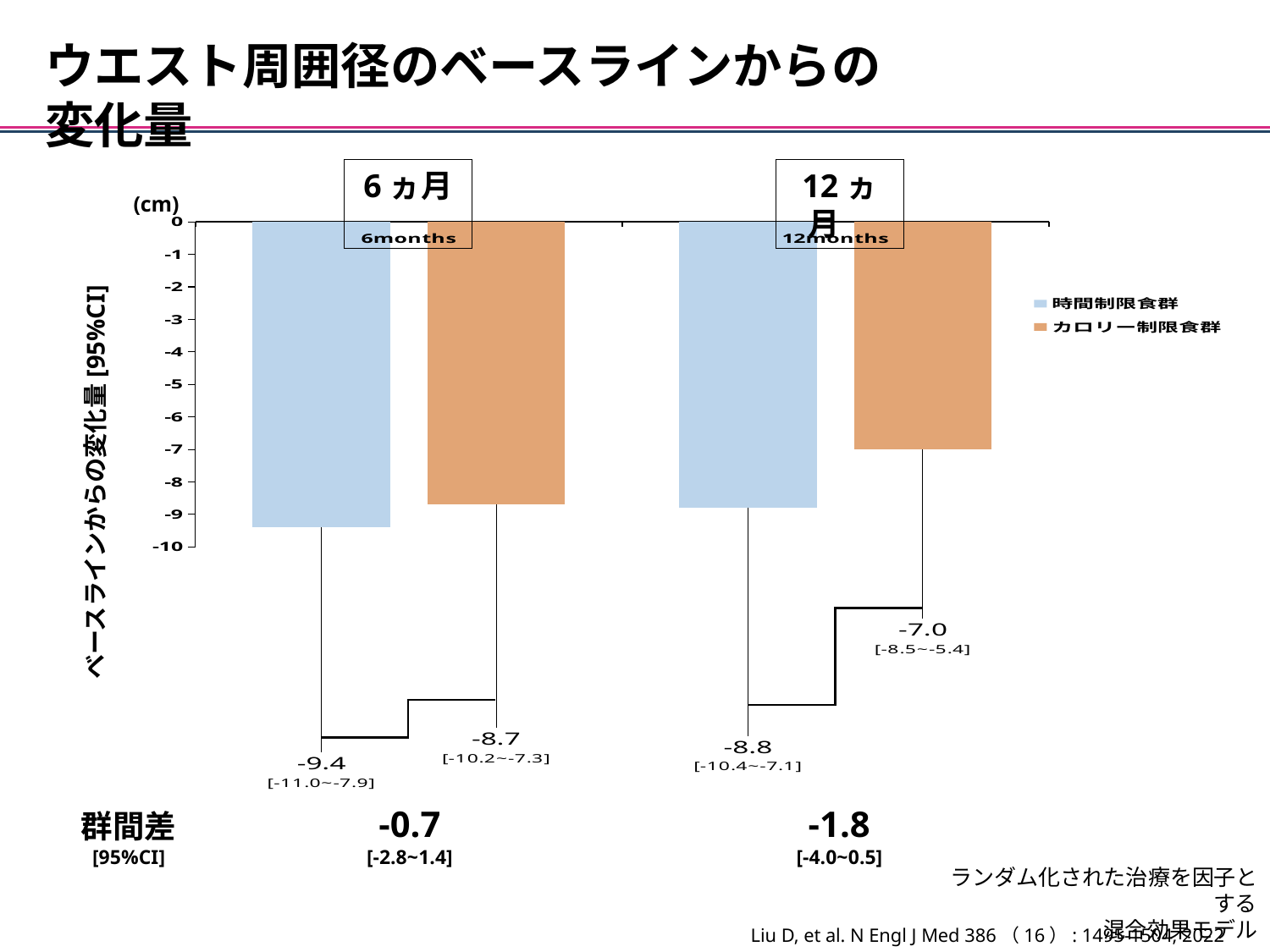
What is the value for the カロリー制限食群 at 6months? -8.7 Which bar shows the smallest decrease from baseline? カロリー制限食群 at 12months What is the value for the 時間制限食群 at 12months? -8.8 What is the value for the カロリー制限食群 at 12months? -7.0 How many series does the legend list? 2 What is the value for the 時間制限食群 at 6months? -9.4 What kind of chart is shown on the slide? bar chart What is the 群間差 (between-group difference) shown for 12months? -1.8 Which bar shows the largest decrease from baseline? 時間制限食群 at 6months What is the 95% confidence interval shown for the 時間制限食群 at 6months? [-11.0~-7.9] What is the difference between the 時間制限食群 and カロリー制限食群 values at 12months? 1.8 Is the value for the カロリー制限食群 at 12months greater or less than -8? greater